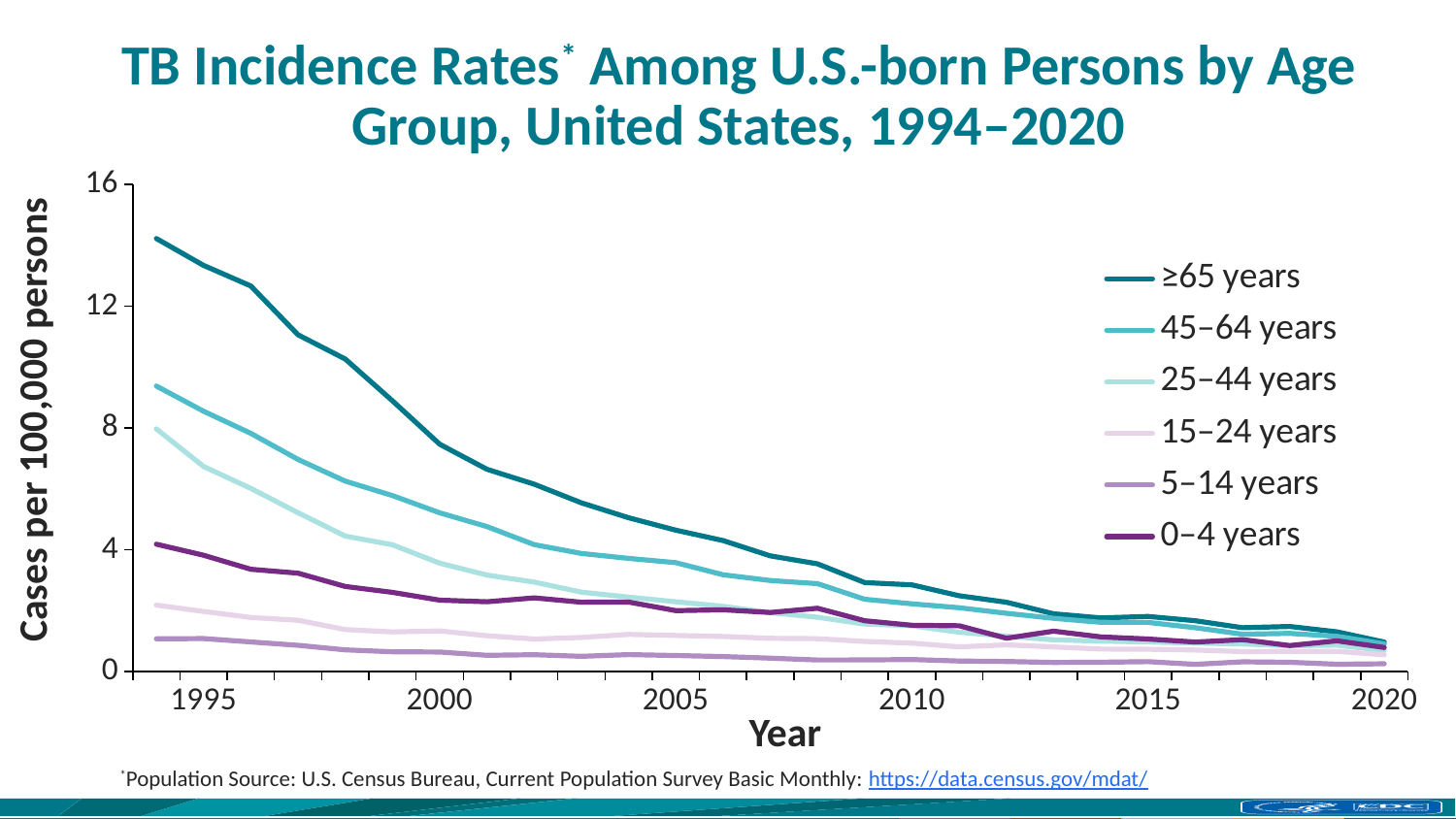
How many series does the legend list? 6 Is the value for the 45–64 years group in 1994 greater or less than 8? greater Is the value for the ≥65 years group in 2010 greater or less than 4? less Is the value for the 5–14 years group in 1995 greater or less than 4? less In 1994, which is larger: the rate for the 0–4 years group or the 15–24 years group? 0–4 years What is the label of the y axis? Cases per 100,000 persons Does the TB incidence rate for the ≥65 years group rise or fall from 1994 to 2020? fall In 2000, which is larger: the rate for the ≥65 years group or the 45–64 years group? ≥65 years Which age group has the highest TB incidence rate in 1994? ≥65 years Which age group has the lowest TB incidence rate in 1994? 5–14 years What kind of chart is shown on the slide? line chart